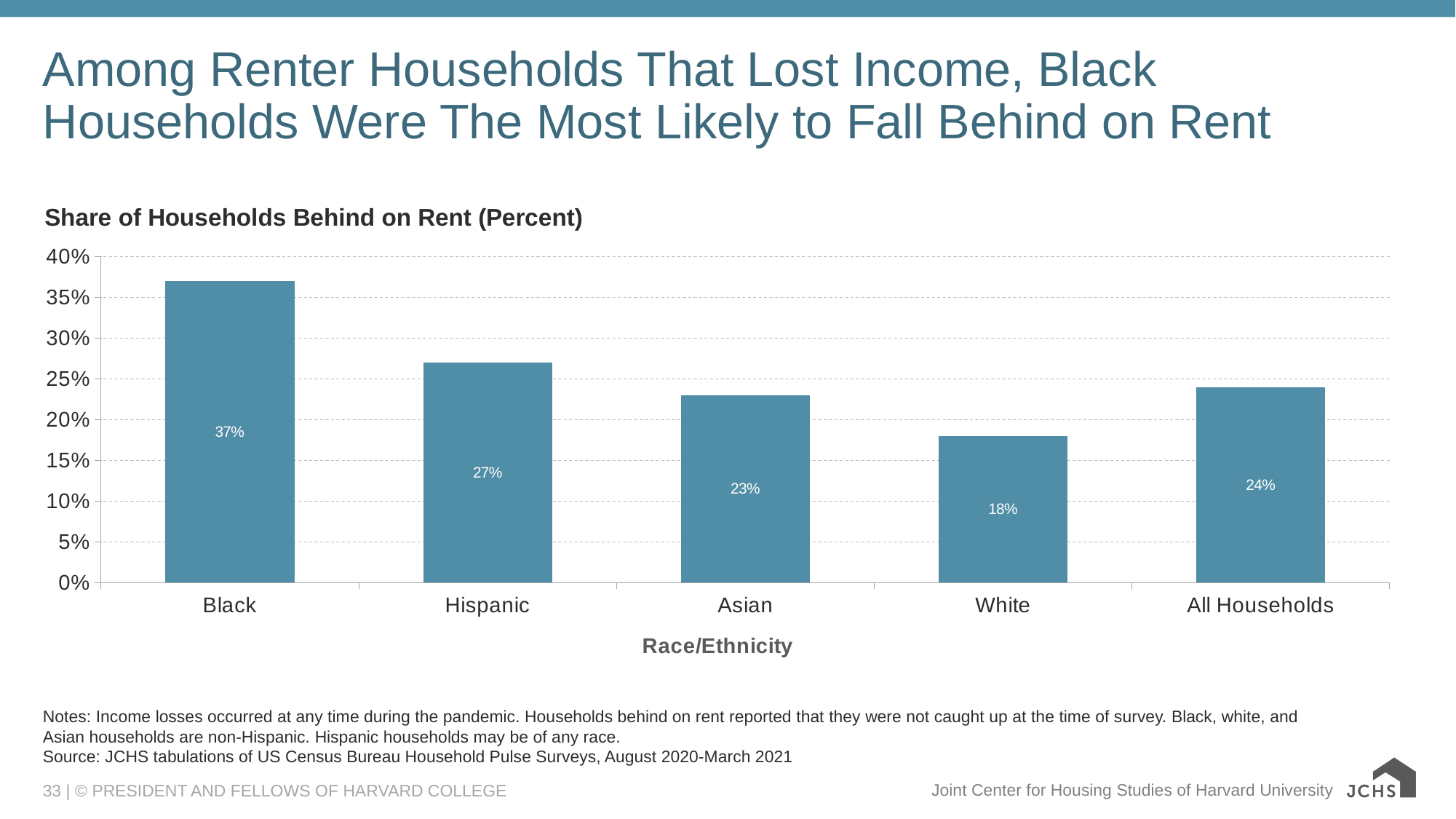
What is the difference in percentage points between the Hispanic and Asian bars? 4 What is the difference in percentage points between the Black and White bars? 19 What kind of chart is shown on the slide? Bar chart What is the share of White households behind on rent? 18% Is the value for Hispanic households greater or less than 25%? greater Which is larger, the value for Asian households or the value for All Households? All Households What is the share of Black households behind on rent? 37% How many race/ethnicity categories are shown on the x axis? 5 Which race/ethnicity category has the highest share of households behind on rent? Black What is the value shown for All Households? 24% Which race/ethnicity category has the lowest share of households behind on rent? White What is the label of the x axis? Race/Ethnicity